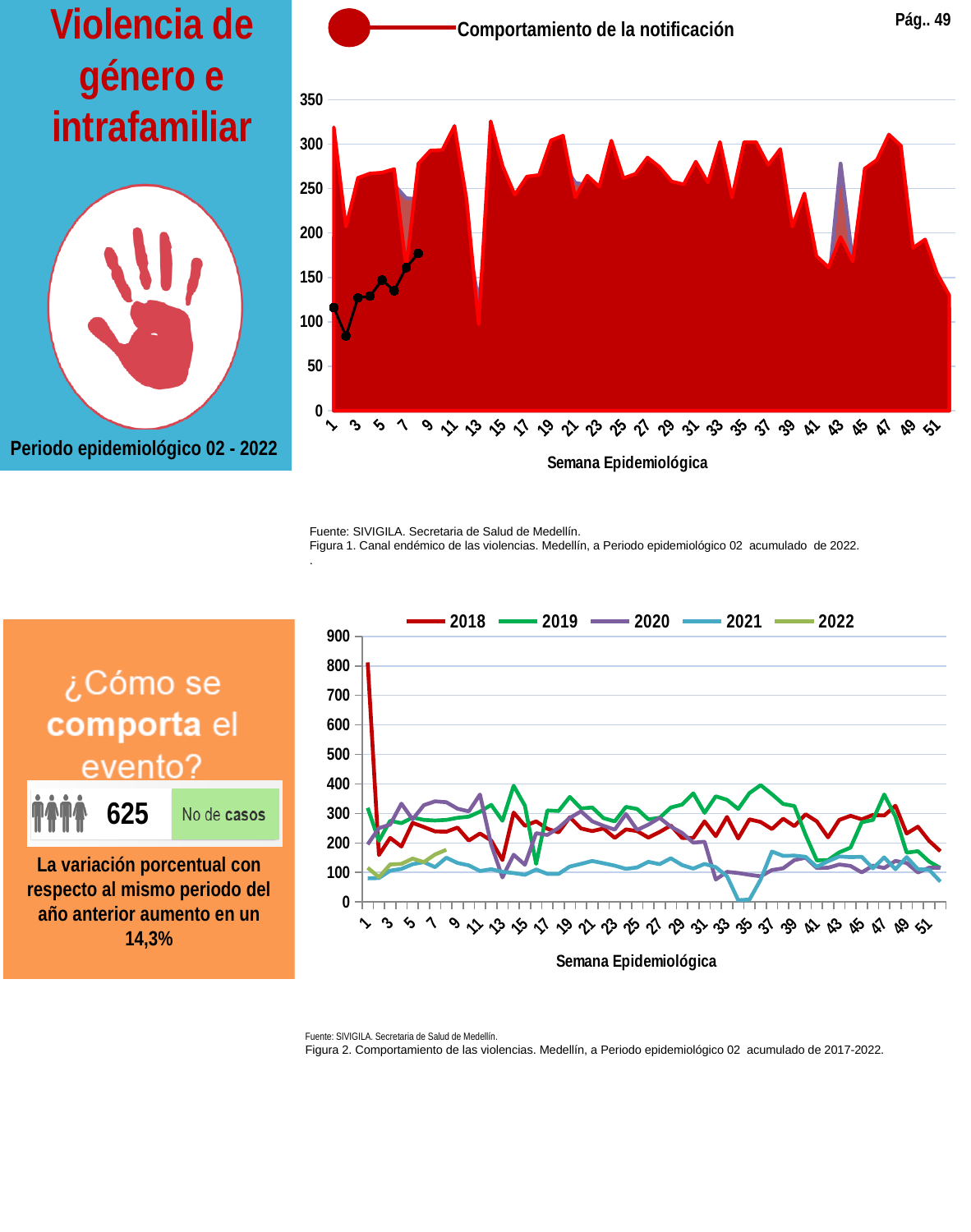
In the top chart 'Comportamiento de la notificación', does the black line overall rise or fall from week 1 to week 8? rise In the bottom chart, which colour is used for the 2020 series? purple What is the x-axis title of the bottom chart? Semana Epidemiológica In the top chart 'Comportamiento de la notificación', is the value of the black line at week 2 greater or less than 100? less In the bottom chart, is the value of the 2018 series at week 1 greater or less than 700? greater In the bottom chart, at week 1, which is larger: the 2018 value or the 2021 value? 2018 In the top chart 'Comportamiento de la notificación', is the value of the black line at week 8 greater or less than 150? greater What kind of chart is the bottom chart (Figure 2, with the 2018–2022 legend)? line chart How many series does the legend of the bottom chart list? 5 In the bottom chart, which series has the highest value at week 1? 2018